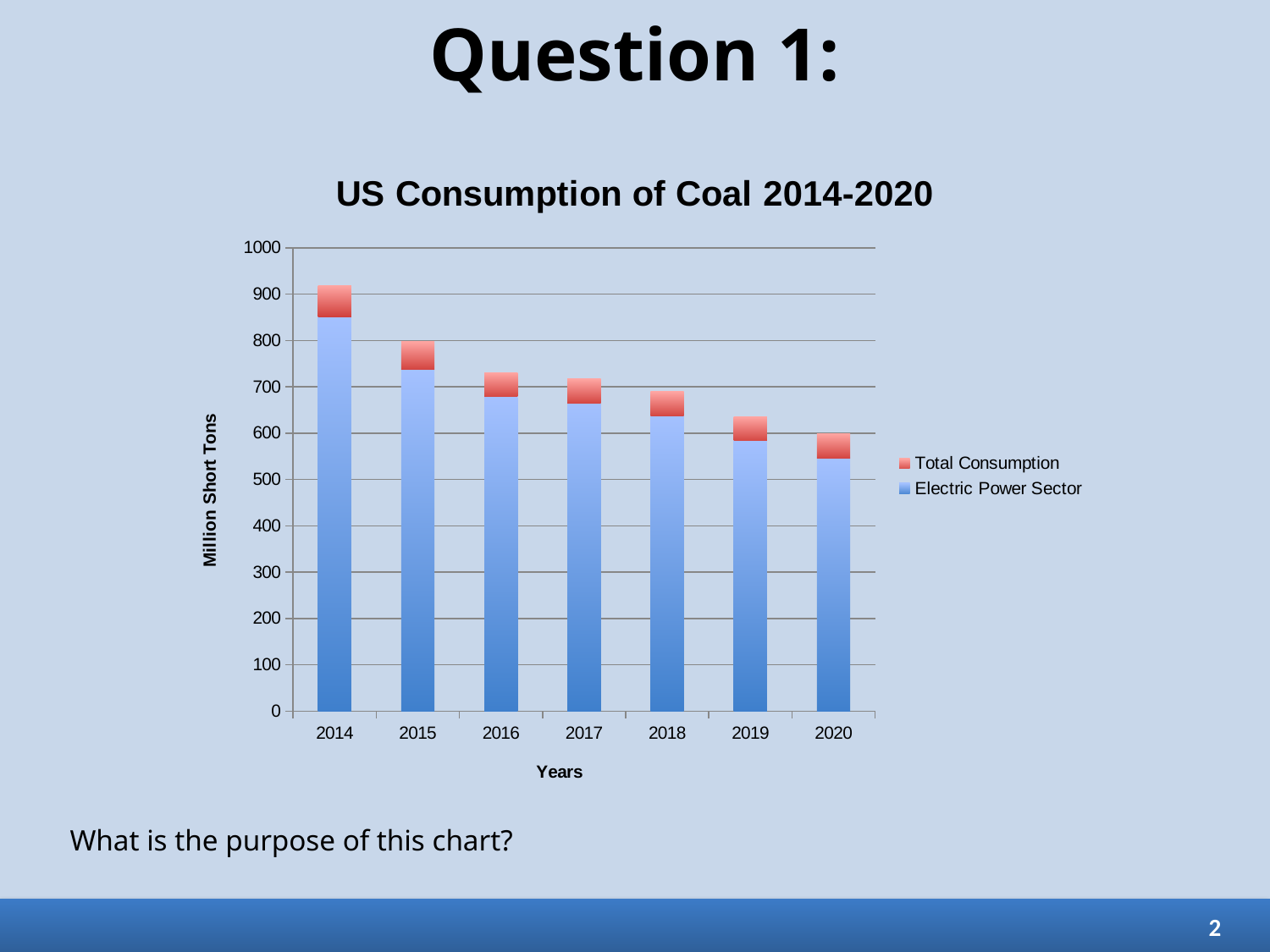
Which year has the tallest bar? 2014 Which year has the shortest bar? 2020 What kind of chart is shown on the slide? Bar chart What is the label on the vertical axis of the chart? Million Short Tons Is the Electric Power Sector value for 2018 greater or less than 700? less What is the title of the chart? US Consumption of Coal 2014-2020 How many years are shown along the x axis? 7 How many series does the legend list? 2 Is the Electric Power Sector value for 2020 greater or less than 600? less Is the Electric Power Sector value for 2014 greater or less than 800? greater Do the bars rise or fall from 2014 to 2020? Fall